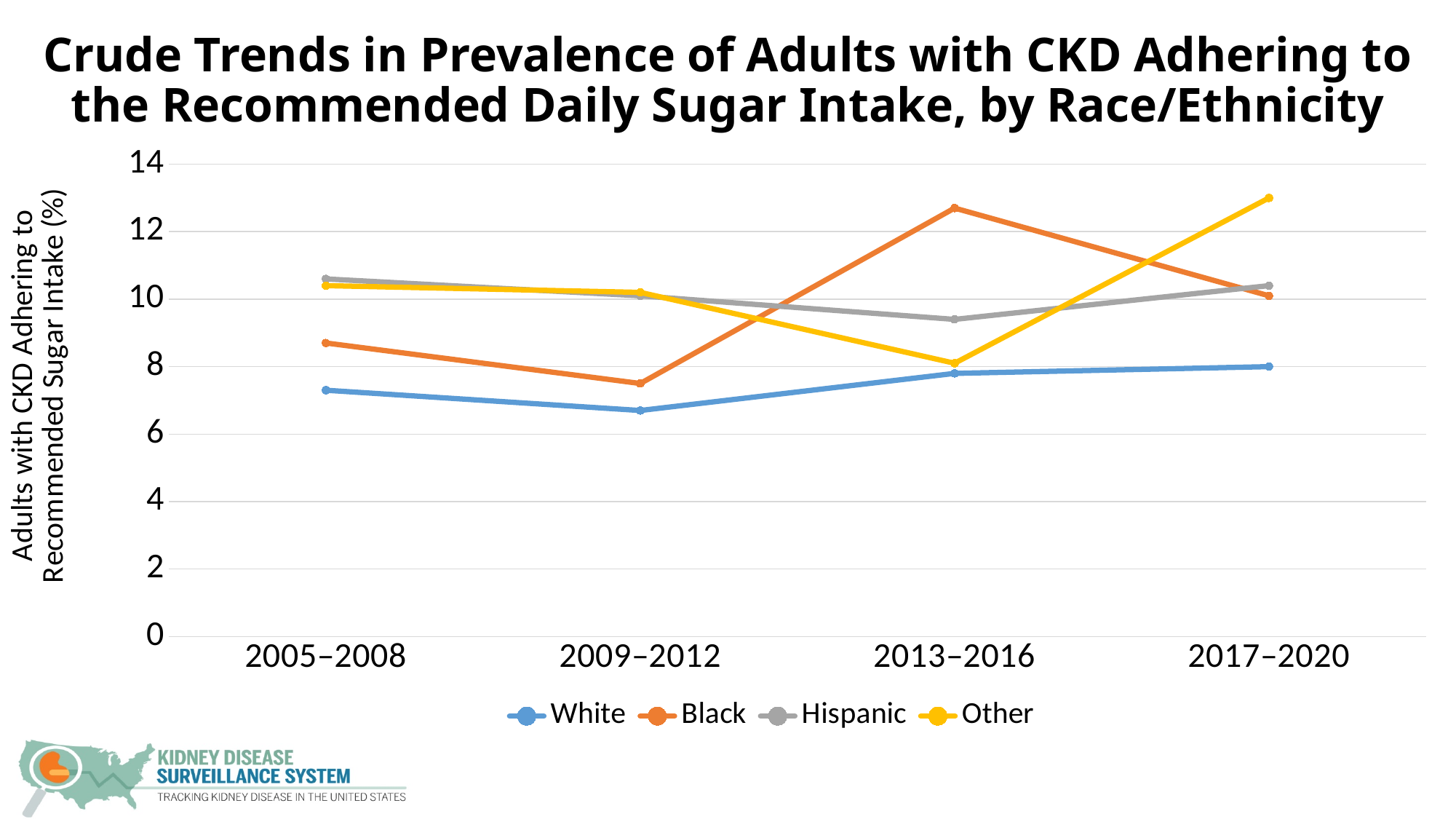
How many series does the legend list? 4 Which race/ethnicity group has the highest value in 2017–2020? Other Is the value for White in 2009–2012 greater or less than 8? less Does the White line rise or fall from 2009–2012 to 2017–2020? rise Which race/ethnicity group has the highest value in 2013–2016? Black Is the value for Other in 2017–2020 greater or less than 12? greater Which race/ethnicity group has the lowest value in 2009–2012? White Is the value for Black in 2013–2016 greater or less than 12? greater What is the label on the y axis? Adults with CKD Adhering to Recommended Sugar Intake (%) How many time periods are shown on the x axis? 4 In 2005–2008, which is larger: the value for Black or the value for White? Black What kind of chart is shown on the slide? line chart